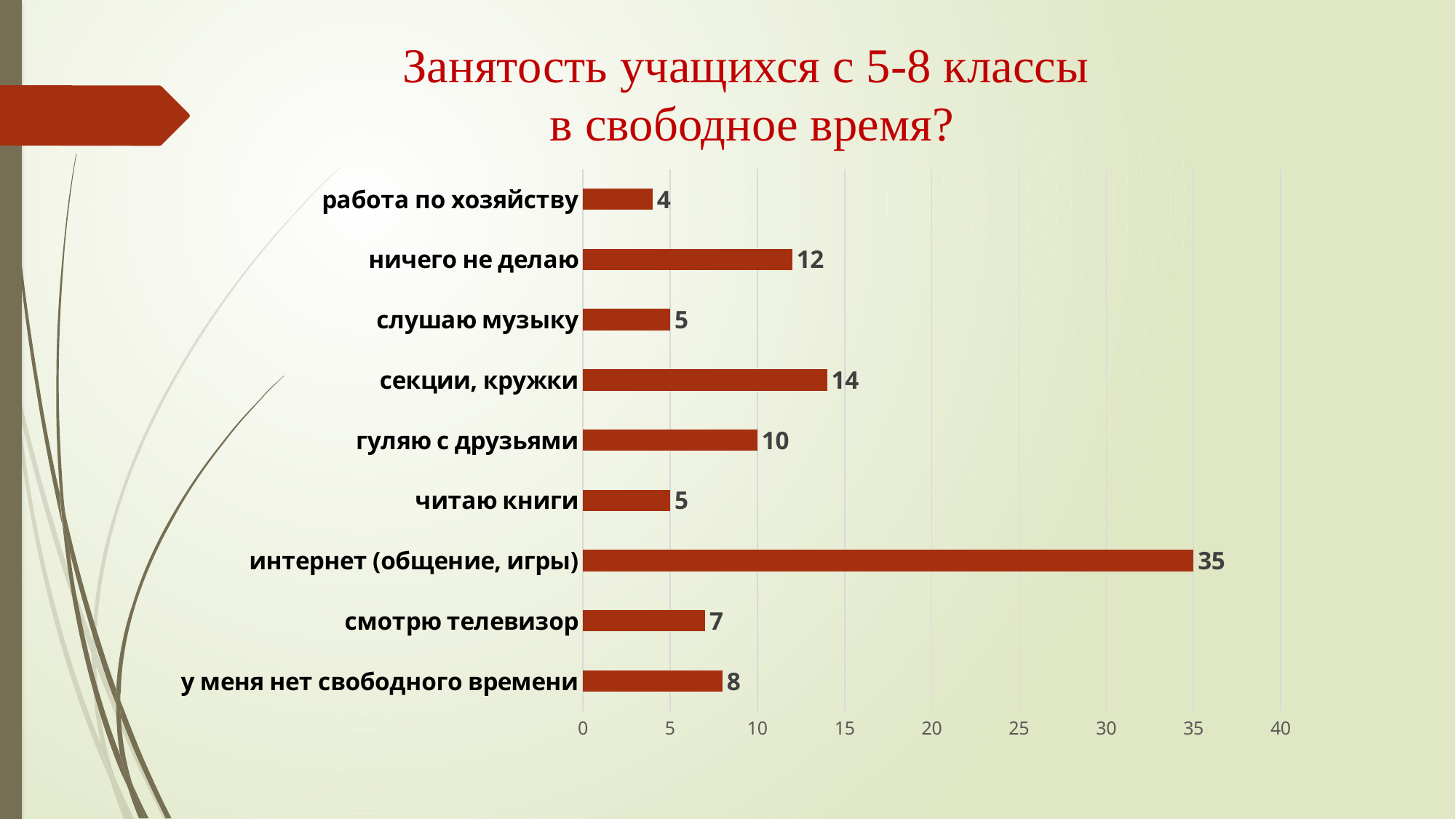
What is the value for секции, кружки? 14 Which category has the highest value? интернет (общение, игры) What kind of chart is shown on the slide? bar chart What is the difference between the values for ничего не делаю and гуляю с друзьями? 2 Which category has the lowest value? работа по хозяйству How many categories are shown in the chart? 9 What is the title of the slide? Занятость учащихся с 5-8 классы в свободное время? What is the value for интернет (общение, игры)? 35 What is the value for у меня нет свободного времени? 8 Is the value for интернет (общение, игры) greater or less than 30? greater Which is larger, the value for смотрю телевизор or the value for у меня нет свободного времени? у меня нет свободного времени What is the difference between the values for интернет (общение, игры) and секции, кружки? 21